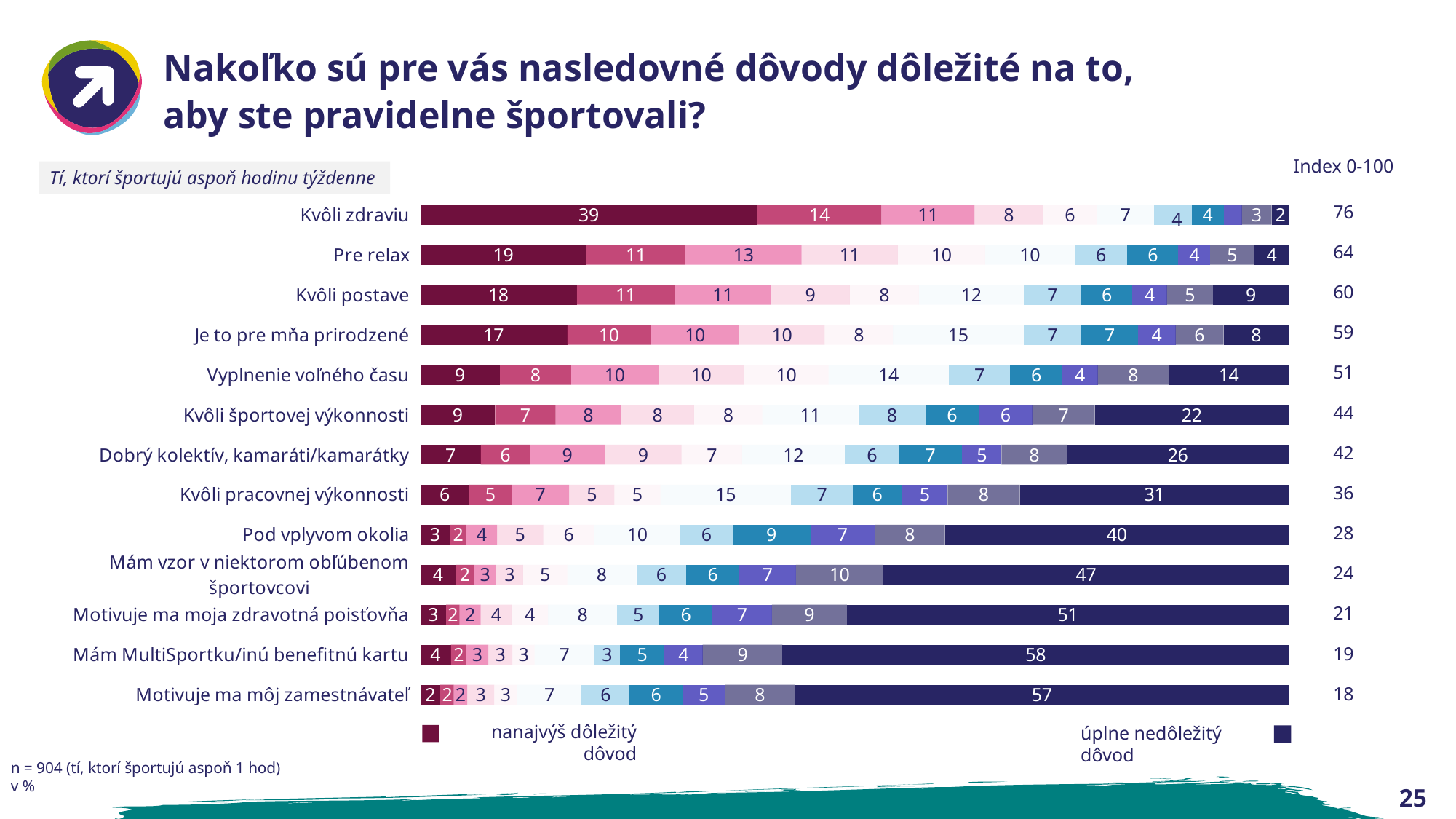
How many reasons (bars) are shown in the chart? 13 What is the value of the last (dark navy, "úplne nedôležitý dôvod") segment for "Motivuje ma moja zdravotná poisťovňa"? 51 What sample size (n) is stated at the bottom left of the slide? n = 904 What is the index value shown for "Vyplnenie voľného času"? 51 Which has a larger "úplne nedôležitý dôvod" segment: "Pod vplyvom okolia" or "Kvôli pracovnej výkonnosti"? Pod vplyvom okolia Do the index values rise or fall going from the top bar to the bottom bar? Fall What kind of chart is shown on the slide? Stacked horizontal bar chart Which reason has the highest index value on the right of the chart? Kvôli zdraviu What is the value of the first (darkest red, "nanajvýš dôležitý dôvod") segment for "Pre relax"? 19 What is the difference between the index values of "Kvôli zdraviu" and "Pre relax"? 12 What is the index value (Index 0-100) shown for "Kvôli zdraviu"? 76 Which reason has the lowest index value on the right of the chart? Motivuje ma môj zamestnávateľ